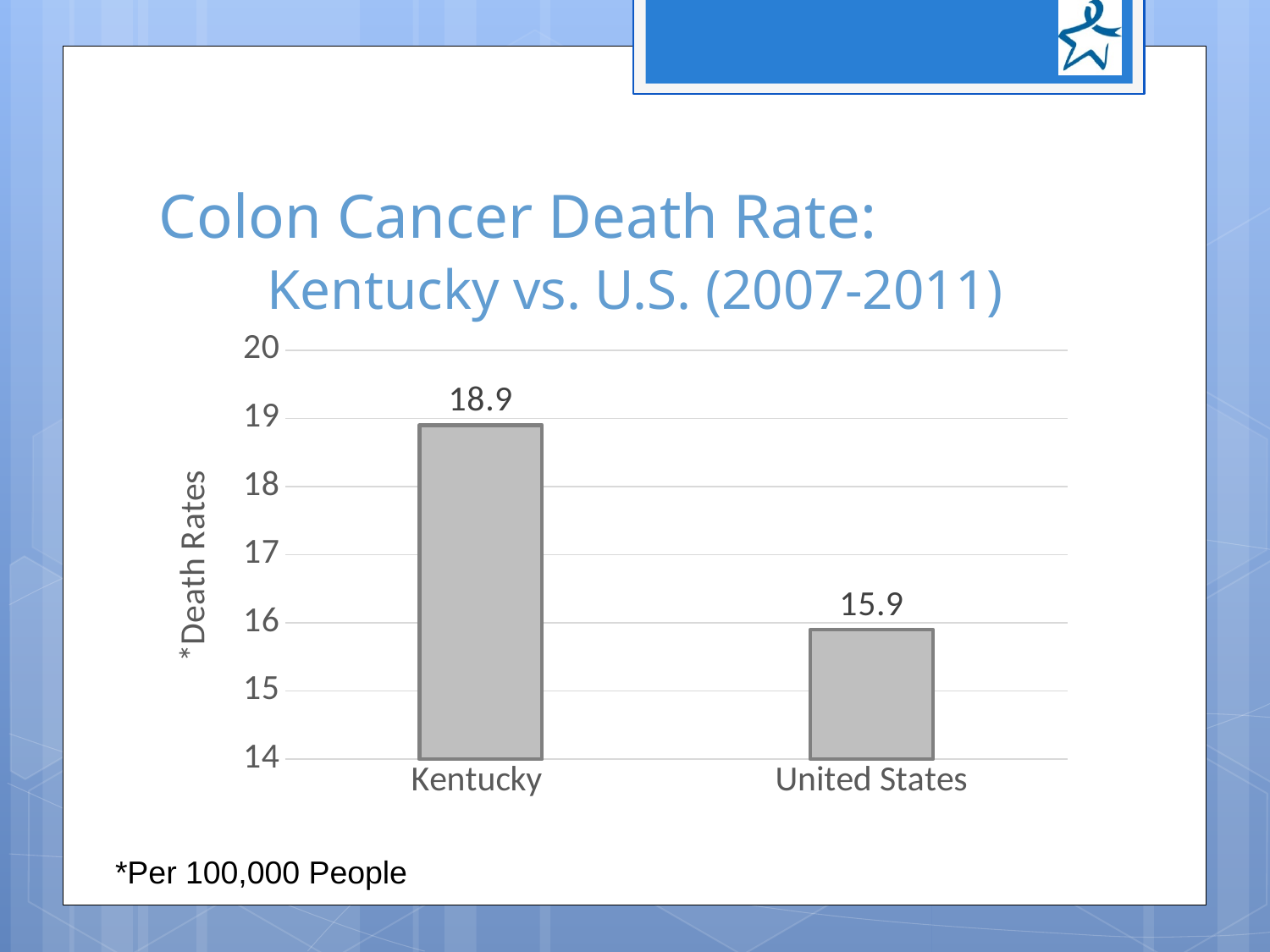
What kind of chart is shown on the slide? bar chart What is the colon cancer death rate for Kentucky? 18.9 Which category has the lowest death rate? United States How many categories are shown in the chart? 2 Which category has the highest death rate? Kentucky What is the label on the vertical axis of the chart? *Death Rates Which is larger, the death rate for Kentucky or for the United States? Kentucky What is the colon cancer death rate for the United States? 15.9 What time period does the chart title say the data covers? 2007-2011 What is the difference between the Kentucky and United States death rates? 3.0 Is the value for Kentucky greater or less than 18? greater Is the value for United States greater or less than 16? less